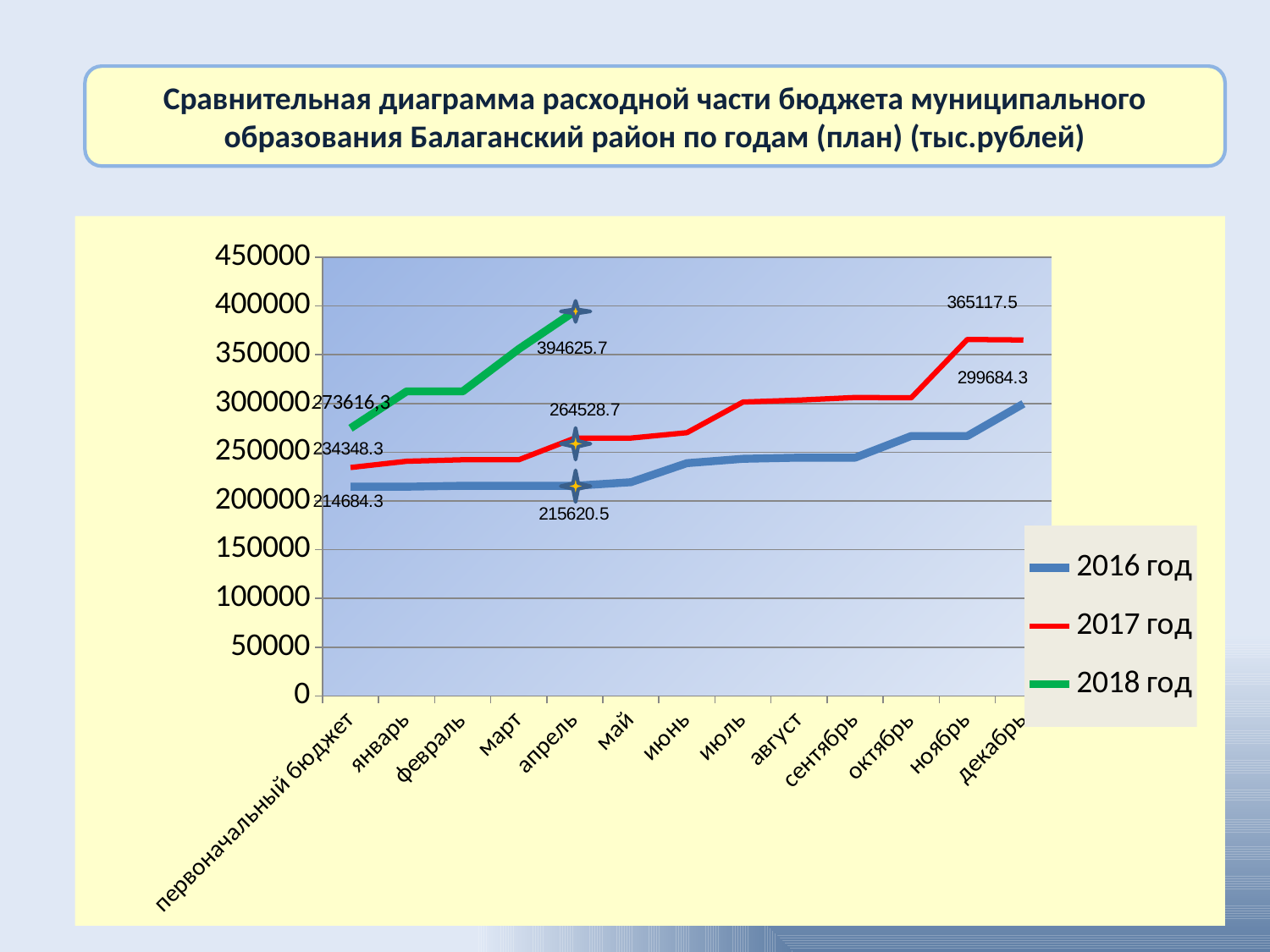
Is the value for 2017 год at июль greater or less than 250000? greater What is the value for 2016 год at первоначальный бюджет? 214684.3 What is the value for 2017 год at первоначальный бюджет? 234348.3 How many series does the legend list? 3 Which colour is used for the 2018 год series? green What kind of chart is shown on the slide? line chart What is the value for 2016 год at апрель? 215620.5 What is the difference between the 2017 год and 2016 год values at первоначальный бюджет? 19664 What is the value for 2018 год at апрель? 394625.7 How many categories are shown along the x axis? 13 Which series has the highest value at первоначальный бюджет? 2018 год What is the difference between the 2018 год and 2017 год values at апрель? 130097